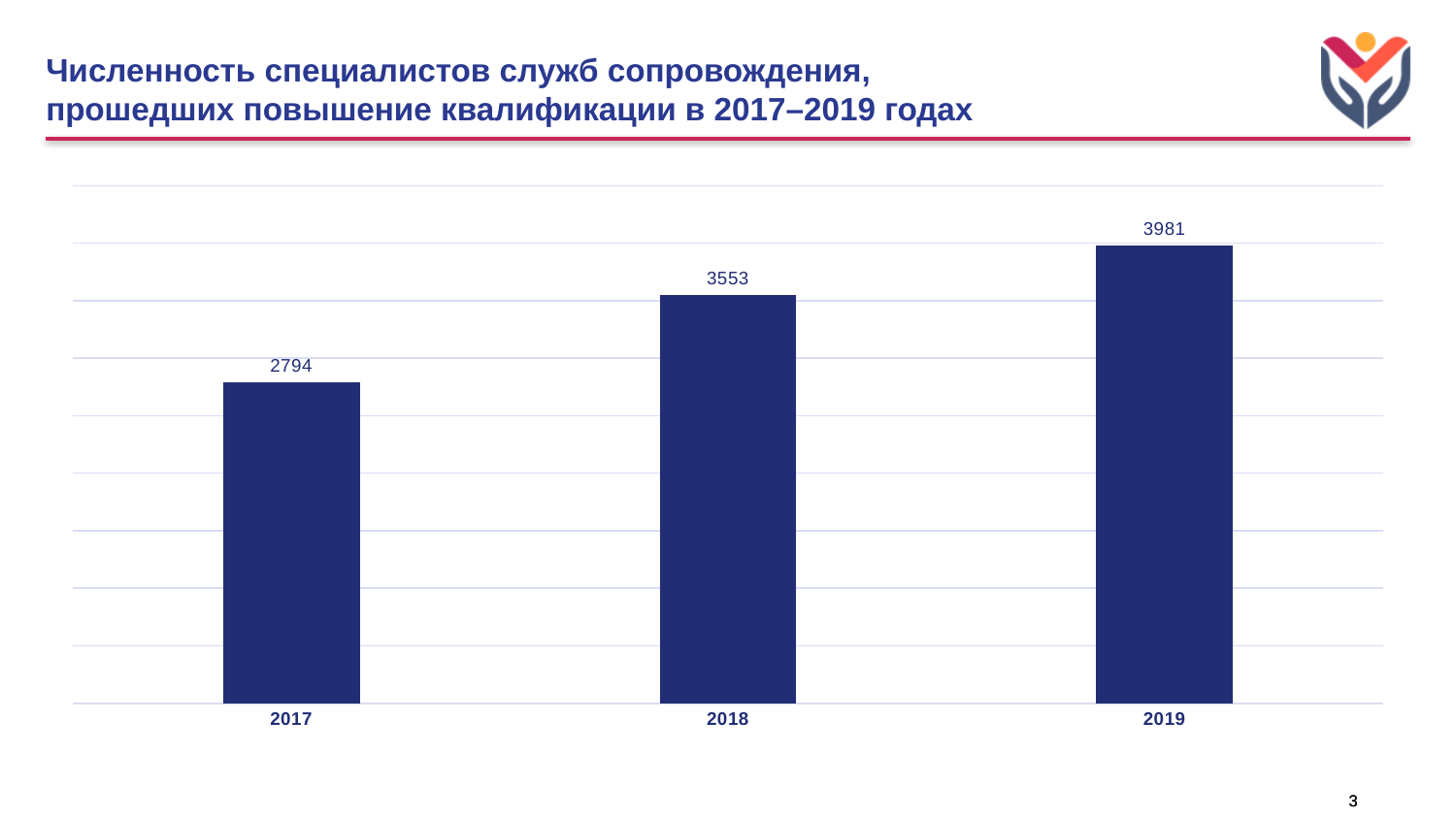
What is the difference between the values for 2019 and 2017? 1187 Which year has the highest value? 2019 How many years are shown on the chart? 3 Do the values rise or fall from 2017 to 2019? rise Which is larger, the value for 2018 or the value for 2017? 2018 What is the value for 2018? 3553 Which year has the lowest value? 2017 What is the difference between the values for 2018 and 2017? 759 What is the value for 2017? 2794 What is the difference between the values for 2019 and 2018? 428 What kind of chart is shown on the slide? bar chart What is the value for 2019? 3981